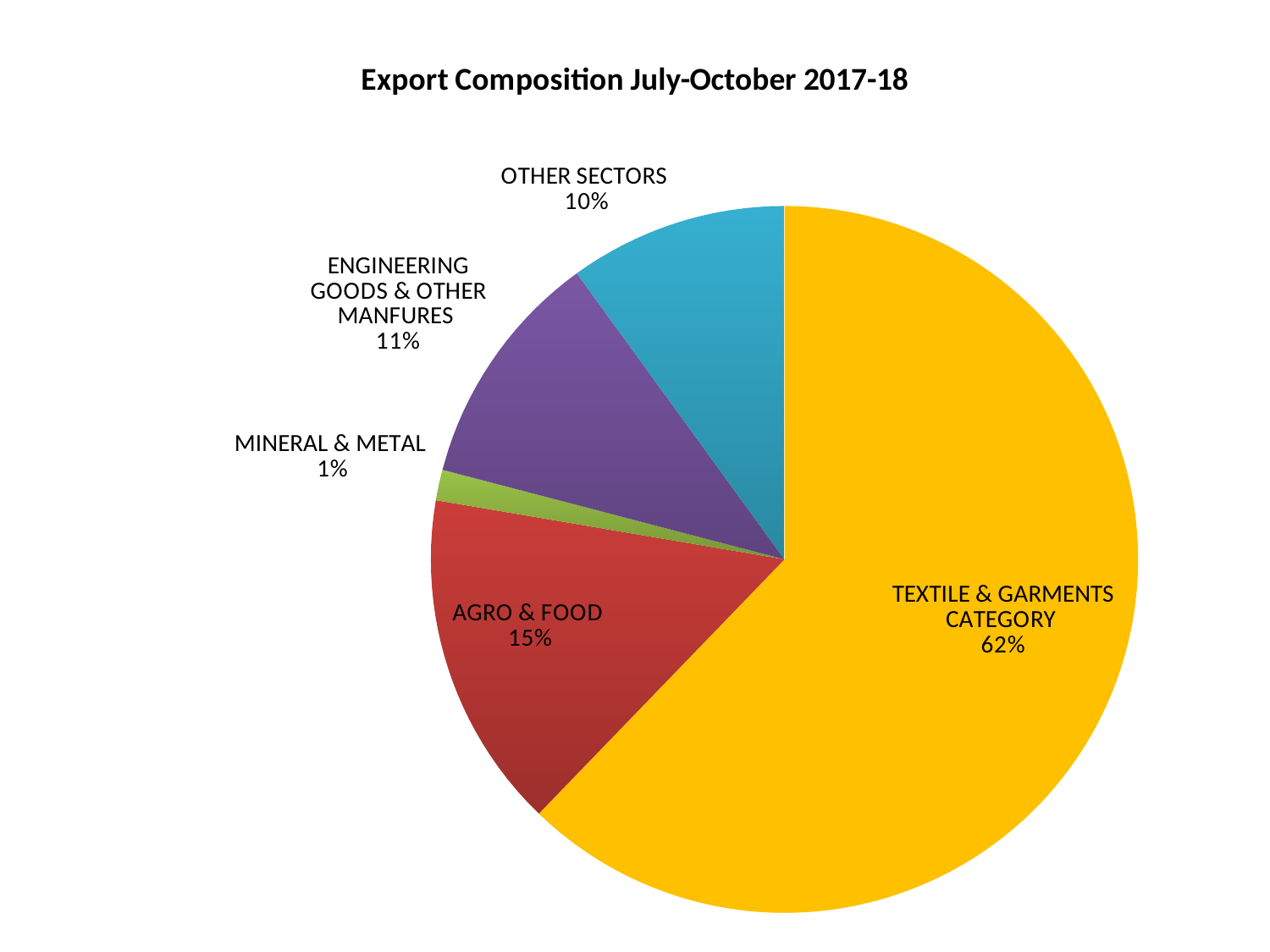
What percentage is shown for OTHER SECTORS? 10% Which category has the largest share of the pie? TEXTILE & GARMENTS CATEGORY What is the difference in percentage points between TEXTILE & GARMENTS CATEGORY and AGRO & FOOD? 47 percentage points How many categories are shown in the pie chart? 5 What percentage is shown for ENGINEERING GOODS & OTHER MANFURES? 11% What share of exports does the TEXTILE & GARMENTS CATEGORY slice represent? 62% What is the title of the chart? Export Composition July-October 2017-18 Which category has the smallest share of the pie? MINERAL & METAL What percentage is shown for MINERAL & METAL? 1% What kind of chart is shown on the slide? pie chart Which is larger, the share for AGRO & FOOD or the share for OTHER SECTORS? AGRO & FOOD What percentage is shown for AGRO & FOOD? 15%